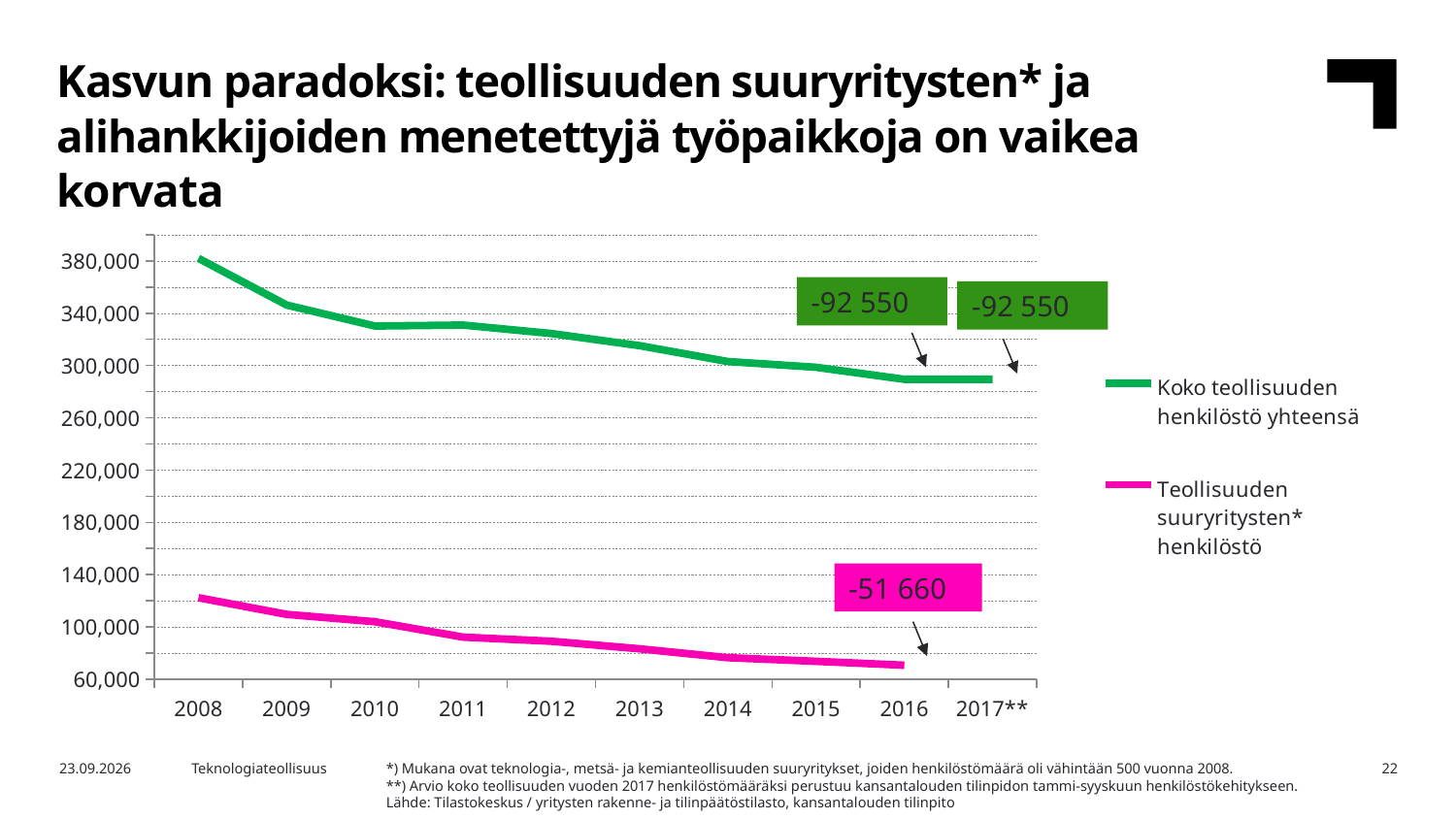
Is the value for 'Koko teollisuuden henkilöstö yhteensä' in 2008 greater or less than 340,000? greater Does the 'Koko teollisuuden henkilöstö yhteensä' series rise or fall from 2008 to 2016? Fall How many series does the legend list? 2 What type of chart is shown on the slide? Line chart How many years are shown on the x axis? 10 In 2010, which series has the larger value: 'Koko teollisuuden henkilöstö yhteensä' or 'Teollisuuden suuryritysten* henkilöstö'? Koko teollisuuden henkilöstö yhteensä Is the value for 'Teollisuuden suuryritysten* henkilöstö' in 2008 greater or less than 100,000? greater What change is printed in the annotation box above the 'Teollisuuden suuryritysten* henkilöstö' line? -51 660 In which year is the 'Koko teollisuuden henkilöstö yhteensä' series at its highest? 2008 Is the value for 'Teollisuuden suuryritysten* henkilöstö' in 2016 greater or less than 100,000? less Does the 'Teollisuuden suuryritysten* henkilöstö' series rise or fall from 2008 to 2016? Fall